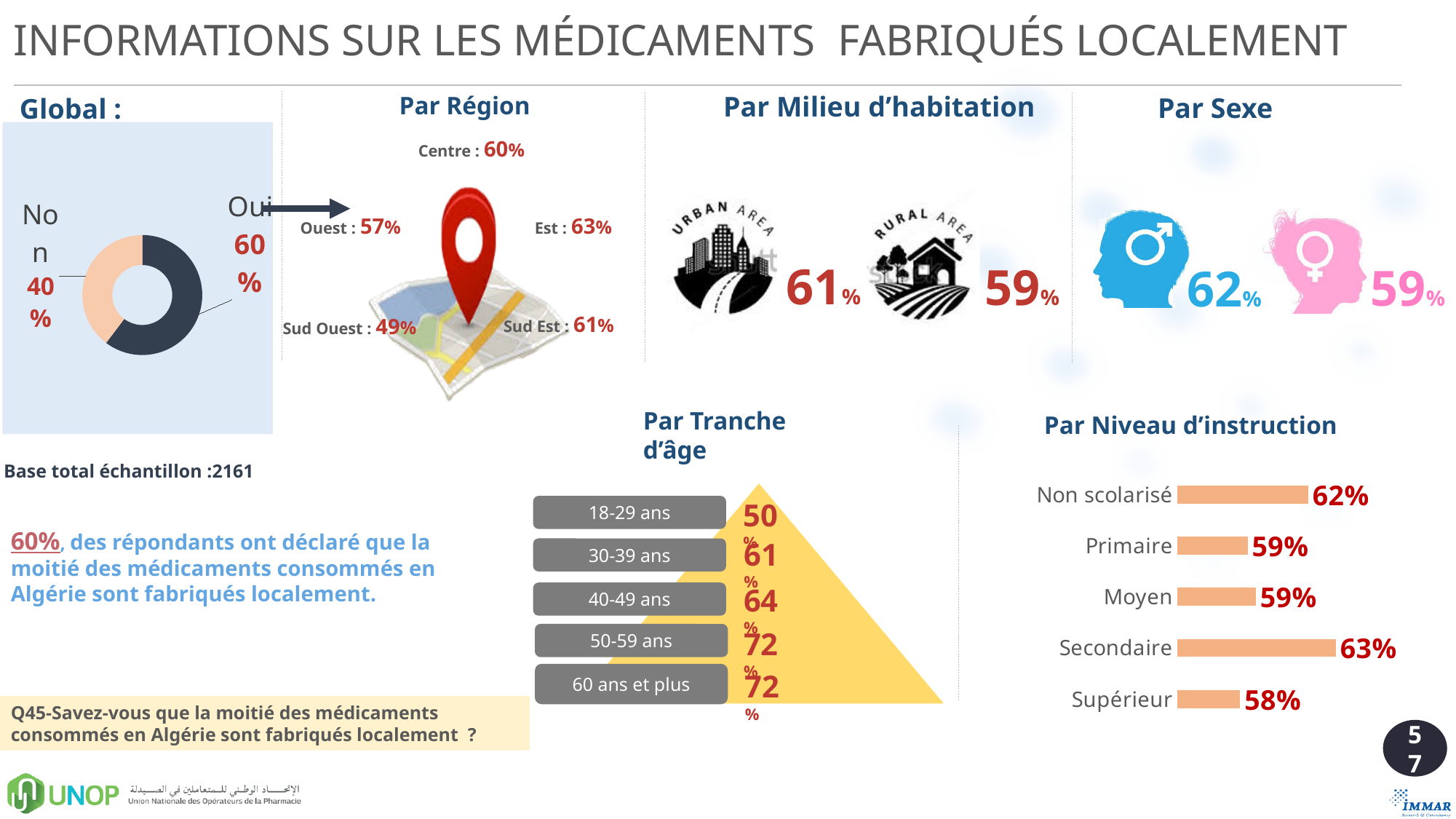
In the 'Par Sexe' chart, what is the value for men? 62% In the 'Par Tranche d'âge' chart, what is the value for 40-49 ans? 64% In the 'Par Tranche d'âge' chart, which age group has the lowest value? 18-29 ans In the 'Global' donut chart, what share of respondents answered 'Oui'? 60% In the 'Global' donut chart, what share of respondents answered 'Non'? 40% In the 'Par Région' chart, what is the value for Sud Ouest? 49% In the 'Par Région' chart, which region has the highest value? Est In the 'Par Région' chart, what is the difference between Est and Ouest? 6% What kind of chart is shown under 'Global'? Donut (pie) chart In the 'Par Niveau d'instruction' bar chart, how many categories are shown? 5 In the 'Par Milieu d'habitation' chart, which is larger, the urban or the rural value? Urban In the 'Par Niveau d'instruction' bar chart, which category has the lowest value? Supérieur